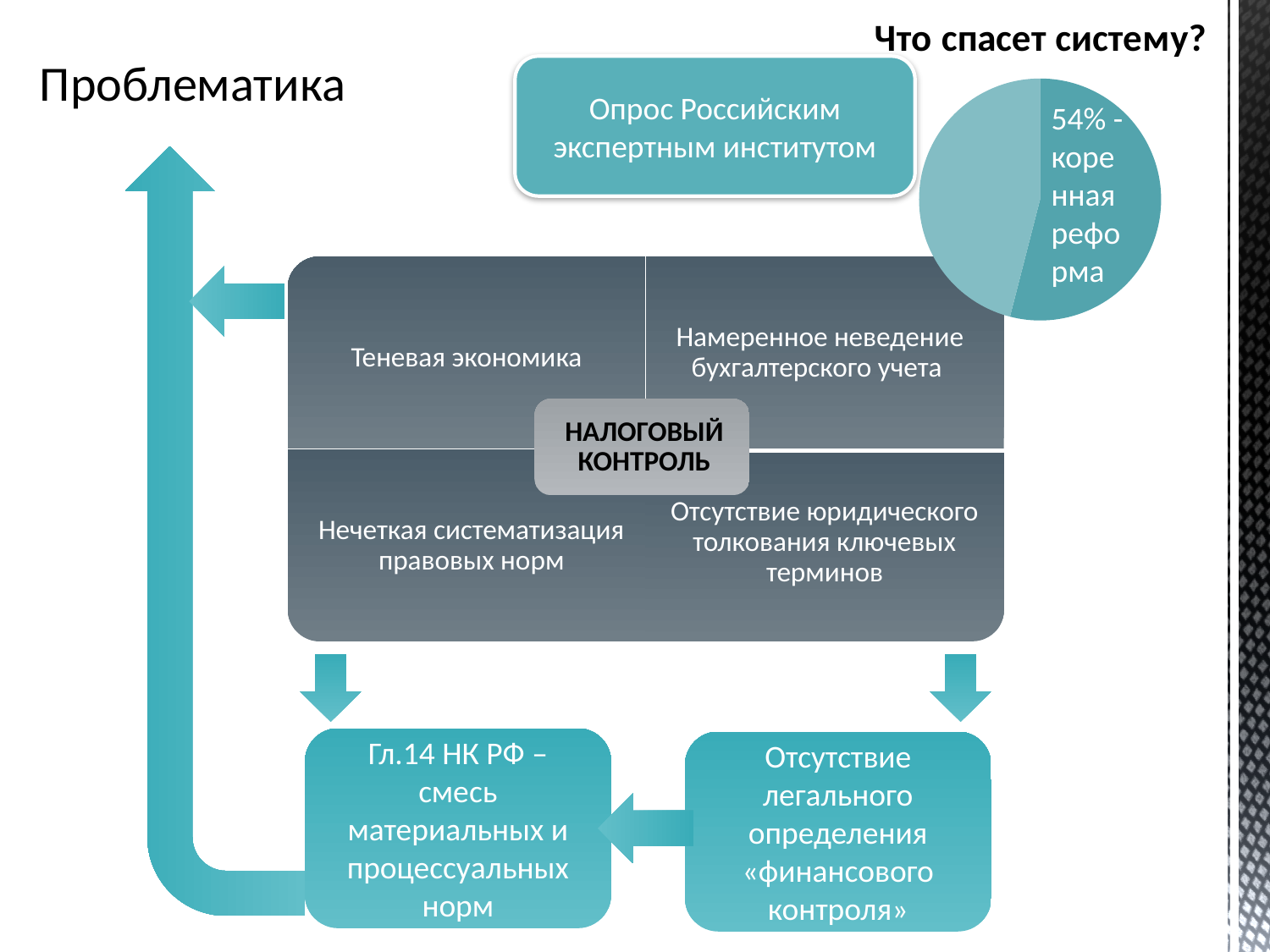
In the pie chart "Что спасет систему?", which slice is larger: the one labelled "коренная реформа" or the unlabelled slice? коренная реформа What kind of chart is shown under the heading "Что спасет систему?"? pie chart In the pie chart "Что спасет систему?", what share is labelled for "коренная реформа"? 54% Is the share for "коренная реформа" in the pie chart greater or less than 50%? greater How many slices does the pie chart "Что спасет систему?" have? 2 What is the title of the pie chart on the slide? Что спасет систему? Which slice of the pie chart "Что спасет систему?" is the largest? 54% - коренная реформа